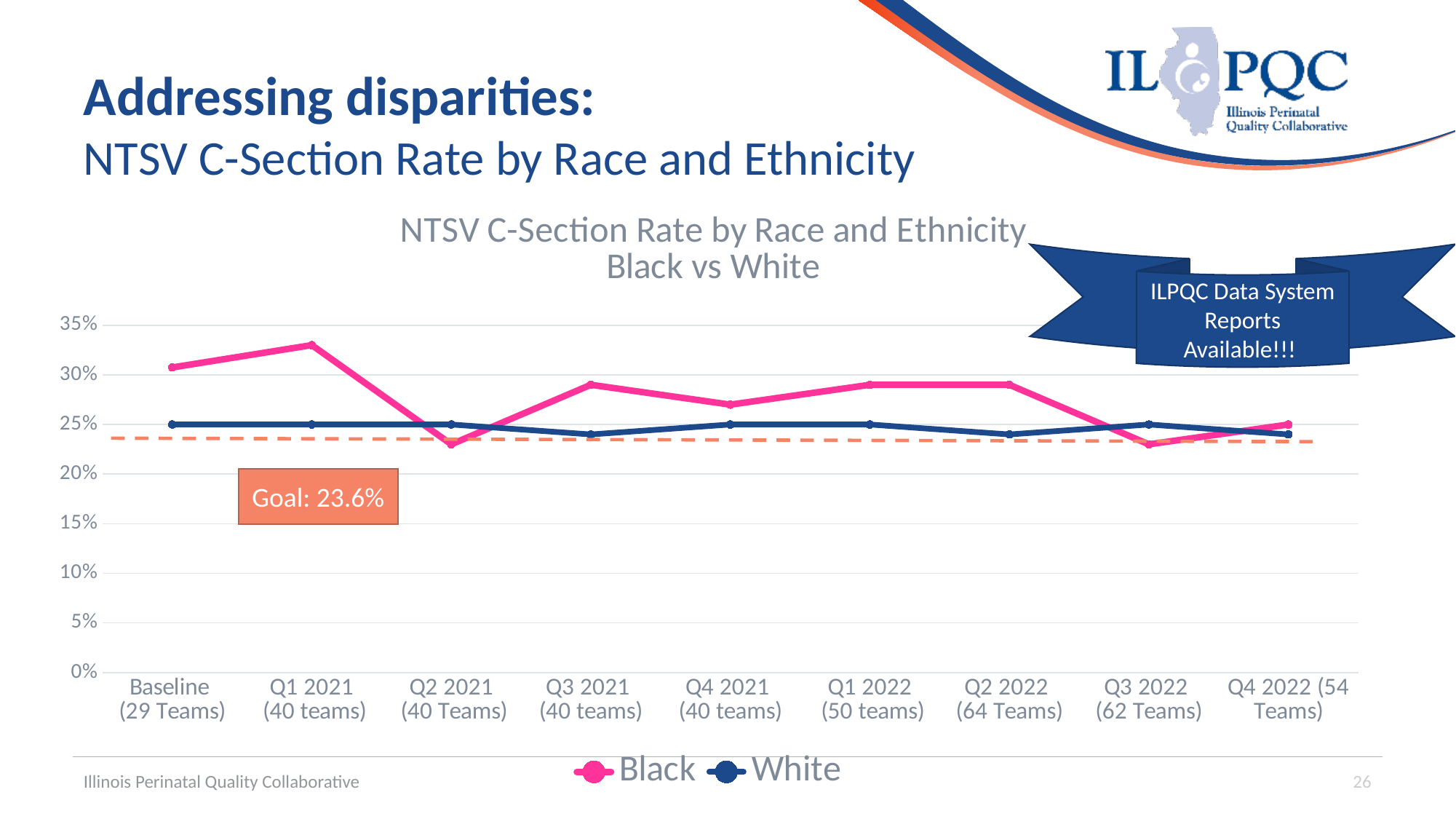
Is the value for the White series at Baseline greater or less than 30%? less At Q1 2021, which series has the higher rate, Black or White? Black How many time points are plotted along the x axis of the chart? 9 What kind of chart is shown on the slide? line chart What goal value is shown on the chart? 23.6% Which time point has the highest NTSV C-section rate for the Black series? Q1 2021 (40 teams) What are the two series named in the chart legend? Black and White Is the value for the Black series at Q2 2021 greater or less than 25%? less How many series does the chart legend list? 2 Is the value for the Black series at Q1 2021 greater or less than 30%? greater At Q2 2021, which series has the higher rate, Black or White? White